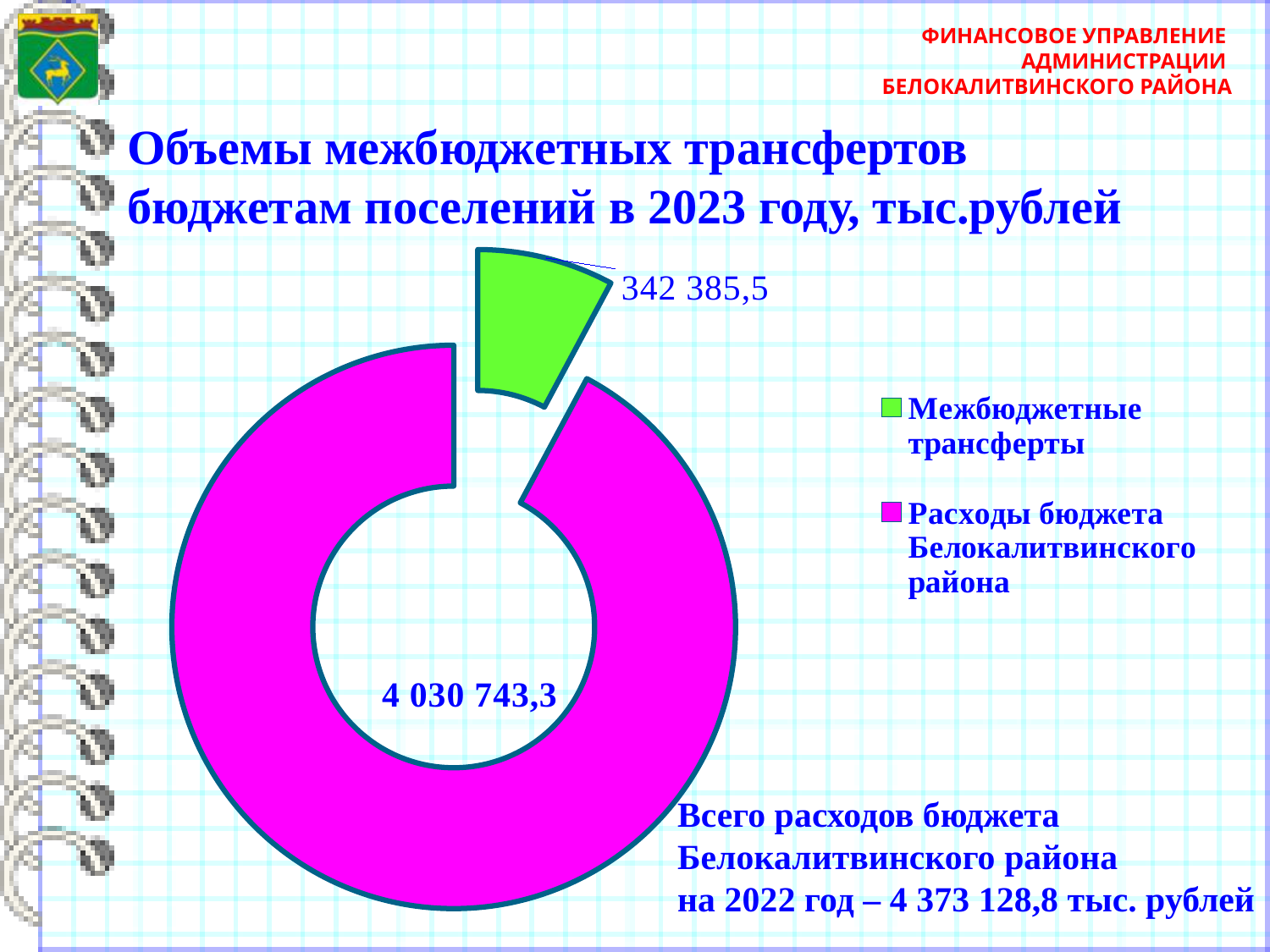
Which category has the smallest value on the chart? Межбюджетные трансферты What is the total of the two values shown on the chart? 4 373 128,8 What is the title of the chart on the slide? Объемы межбюджетных трансфертов бюджетам поселений в 2023 году, тыс.рублей How many categories does the chart show? 2 What colour is the slice for Межбюджетные трансферты? green Which category has the largest value on the chart? Расходы бюджета Белокалитвинского района What value is shown for Расходы бюджета Белокалитвинского района on the chart? 4 030 743,3 What kind of chart is shown on the slide? doughnut chart How many entries does the legend list? 2 What value is shown for Межбюджетные трансферты on the chart? 342 385,5 Which is larger: the value for Межбюджетные трансферты or the value for Расходы бюджета Белокалитвинского района? Расходы бюджета Белокалитвинского района What is the difference between the value for Расходы бюджета Белокалитвинского района and the value for Межбюджетные трансферты? 3 688 357,8